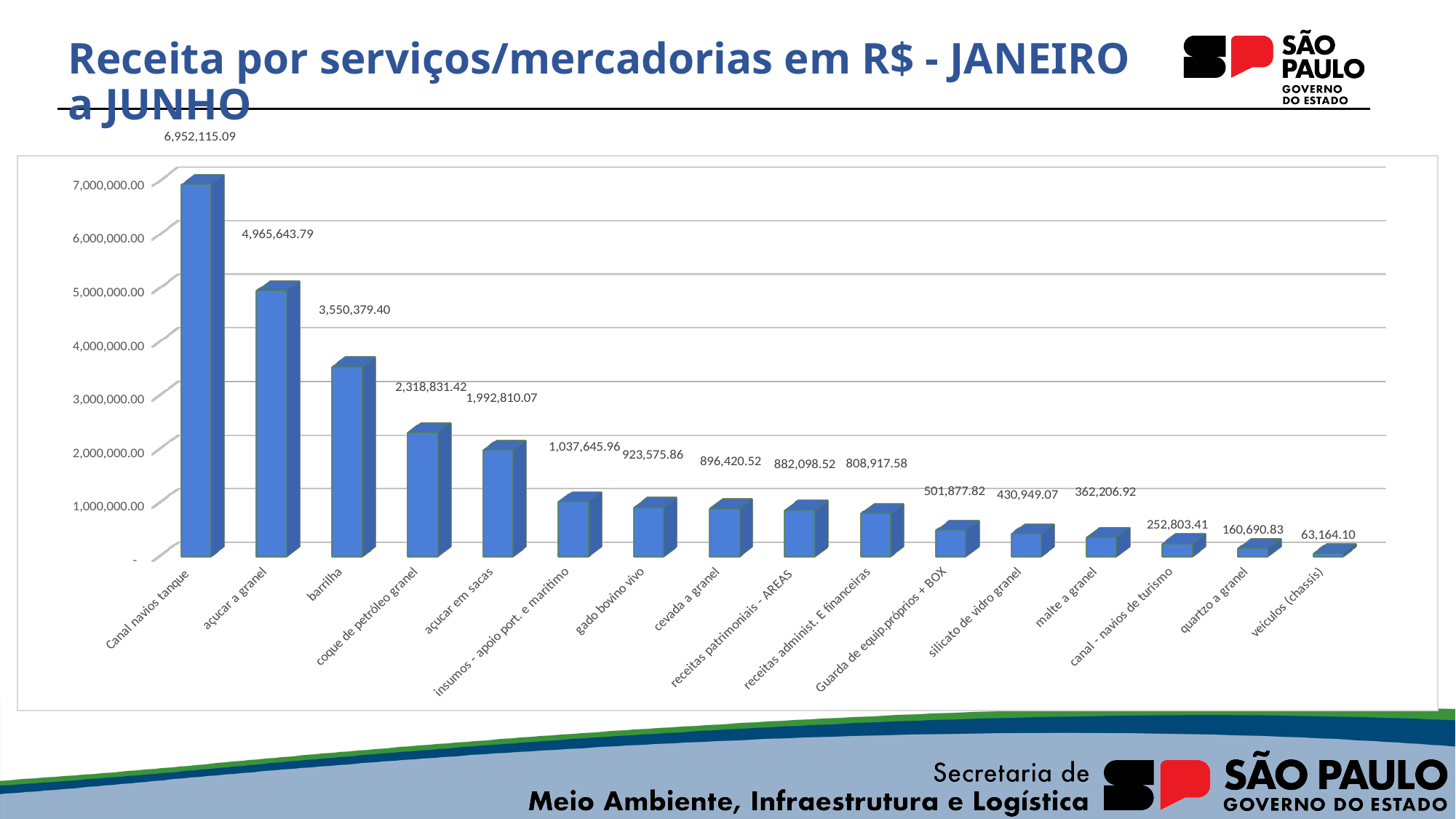
What type of chart is shown on the slide? Bar chart What is the revenue value for 'Canal navios tanque'? 6,952,115.09 What is the revenue value for 'gado bovino vivo'? 923,575.86 Which category has the lowest revenue? veículos (chassis) What is the revenue value for 'barrilha'? 3,550,379.40 How many categories are shown in the chart? 16 What is the title of the slide containing the chart? Receita por serviços/mercadorias em R$ - JANEIRO a JUNHO Which category has the highest revenue? Canal navios tanque What is the difference between the revenue for 'Canal navios tanque' and 'açucar a granel'? 1,986,471.30 What is the revenue value for 'malte a granel'? 362,206.92 Which has a larger revenue, 'gado bovino vivo' or 'cevada a granel'? gado bovino vivo What is the difference between the revenue for 'quartzo a granel' and 'veículos (chassis)'? 97,526.73